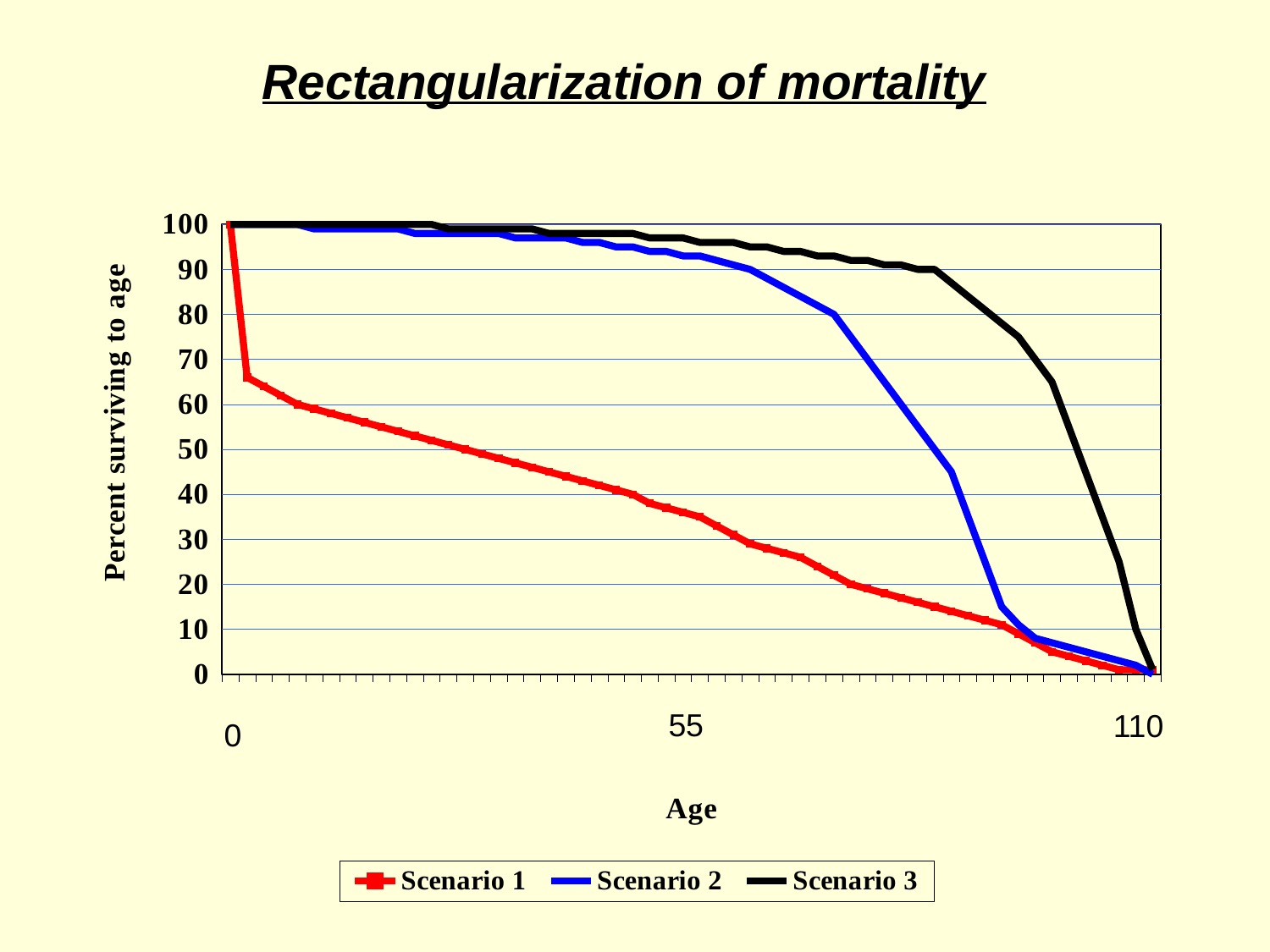
Is the value for Scenario 3 at age 55 greater or less than 90? greater Is the value for Scenario 2 at age 110 greater or less than 10? less Which scenario has the lowest percent surviving at age 55? Scenario 1 Is the value for Scenario 1 at age 55 greater or less than 50? less How many series does the legend list? 3 What is the title of the chart? Rectangularization of mortality What kind of chart is shown on the slide? Line chart Which colour is used for the Scenario 2 line? Blue At age 55, which is larger: the value for Scenario 1 or the value for Scenario 3? Scenario 3 Do the values for Scenario 1 rise or fall as age increases? Fall Do the values for Scenario 3 rise or fall as age increases? Fall